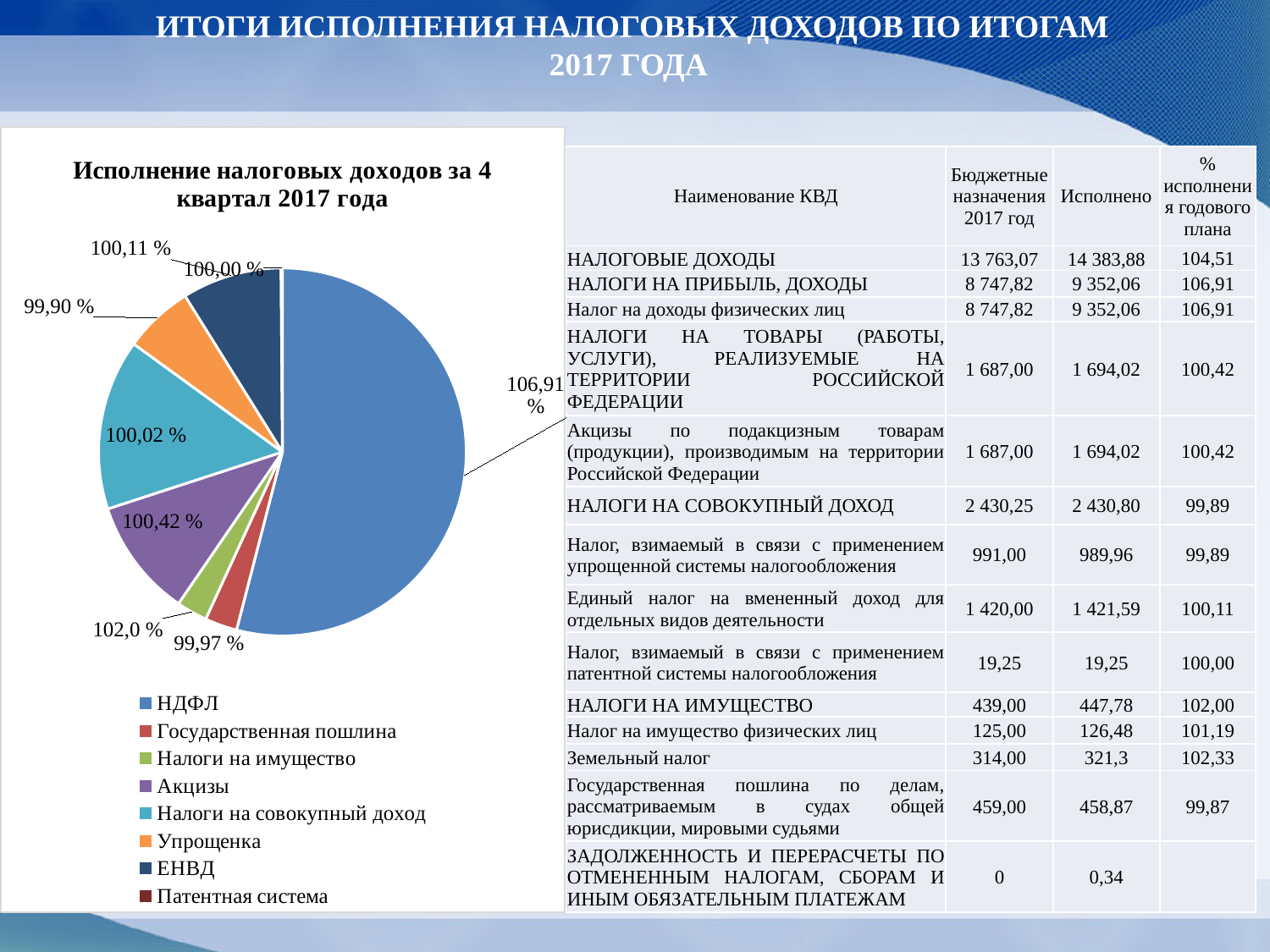
What is the data label shown for the НДФЛ slice of the pie chart? 106,91 % Which category occupies the smallest slice of the pie chart? Патентная система What is the data label shown for the ЕНВД slice of the pie chart? 100,11 % What is the data label shown for the Акцизы slice of the pie chart? 100,42 % What kind of chart is shown on the left of the slide? pie chart What is the data label shown for the Государственная пошлина slice of the pie chart? 99,97 % Which legend entry of the pie chart is shown in orange? Упрощенка How many categories does the pie chart's legend list? 8 What is the data label shown for the Упрощенка slice of the pie chart? 99,90 % Which category occupies the largest slice of the pie chart? НДФЛ What is the title of the pie chart? Исполнение налоговых доходов за 4 квартал 2017 года What is the data label shown for the Налоги на совокупный доход slice of the pie chart? 100,02 %